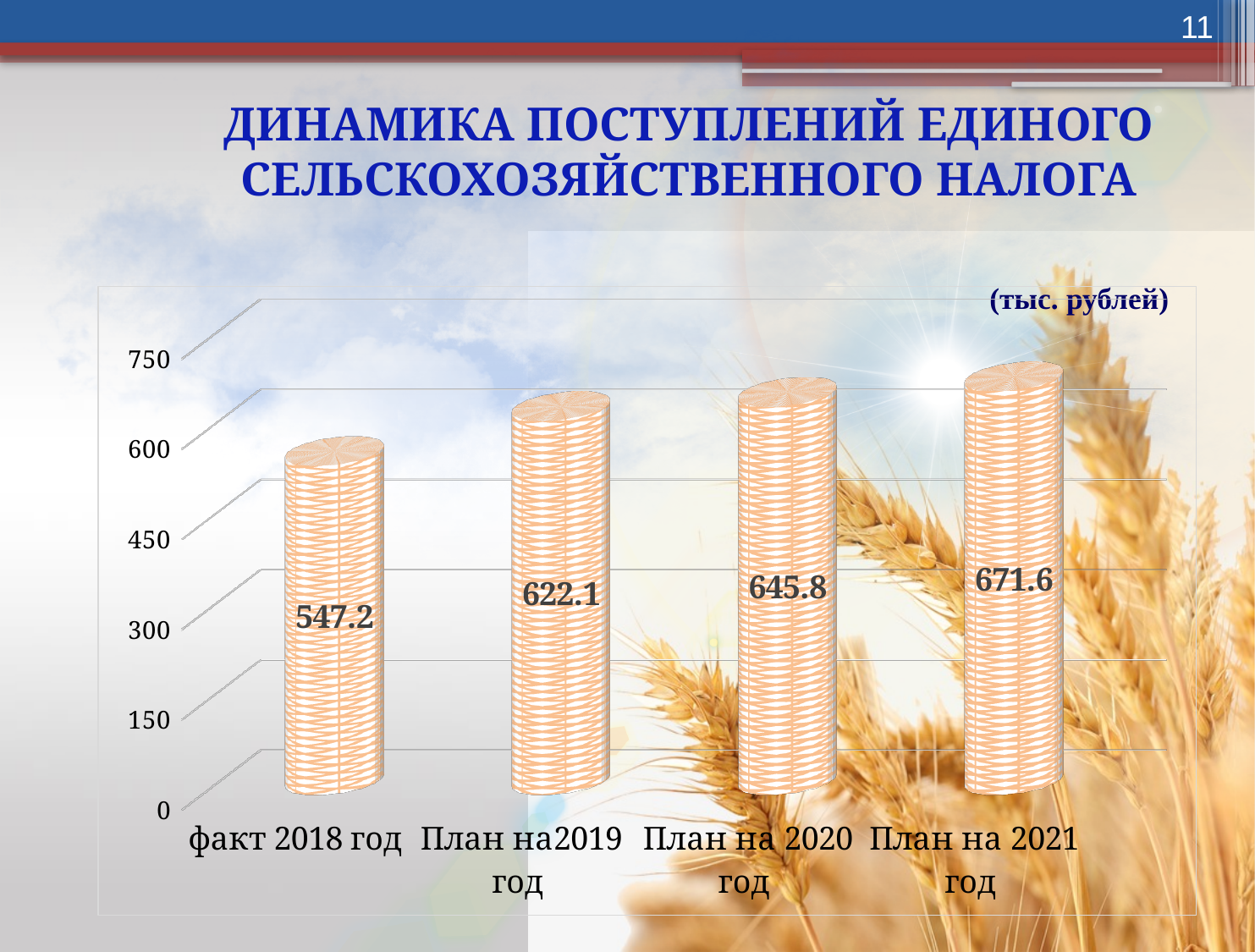
What is the value for План на 2019 год? 622.1 What is the value for факт 2018 год? 547.2 What is the value for План на 2020 год? 645.8 Do the values rise or fall from факт 2018 год to План на 2021 год? Rise What is the difference between the values for План на 2021 год and факт 2018 год? 124.4 Which is larger, the value for План на 2019 год or the value for План на 2020 год? План на 2020 год How many categories are shown on the x axis? 4 Which category has the lowest value? факт 2018 год What unit is indicated for the values in the chart? тыс. рублей What kind of chart is shown on the slide? Bar chart Which category has the highest value? План на 2021 год What is the value for План на 2021 год? 671.6